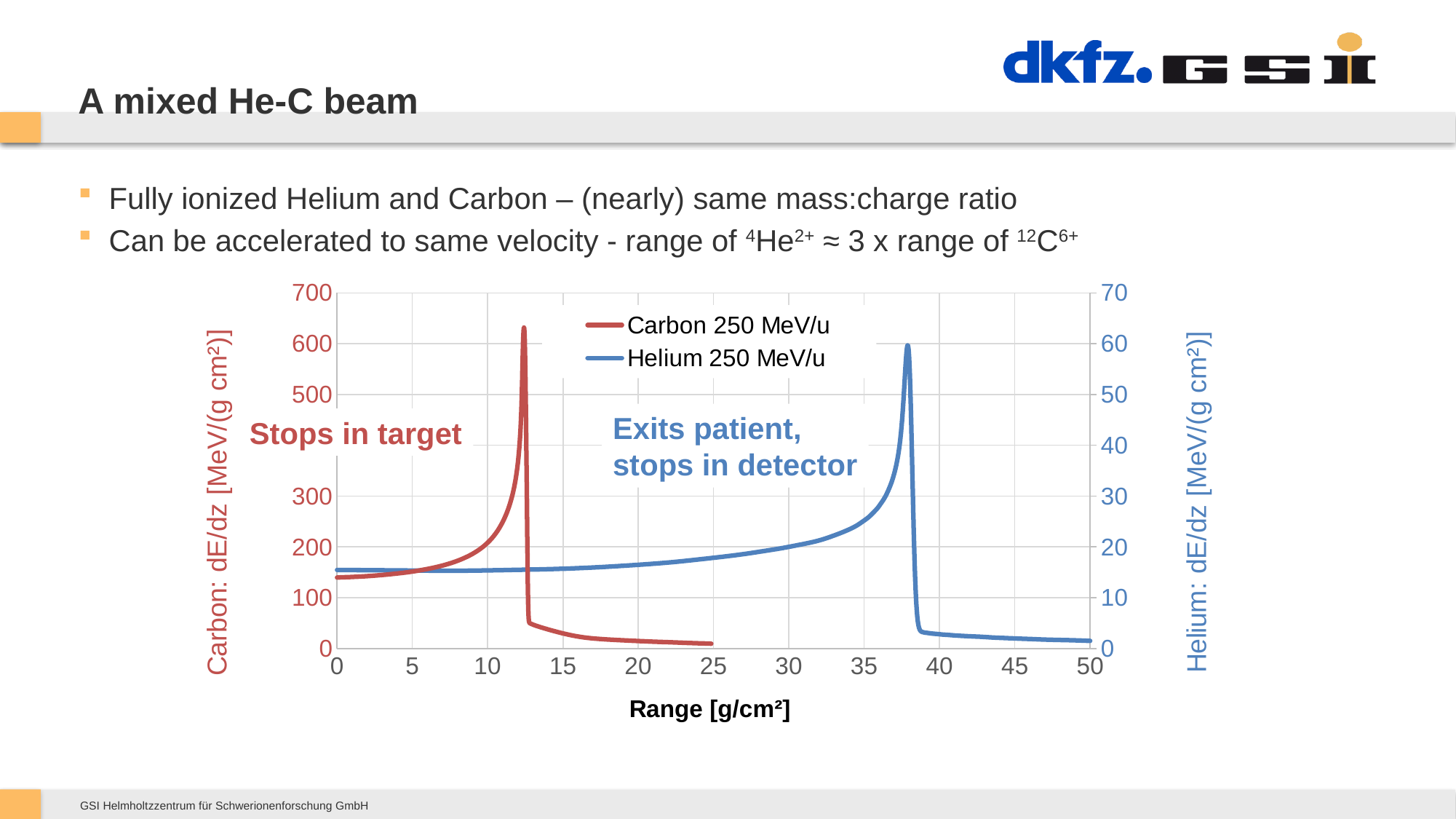
Is the peak value of the Carbon 250 MeV/u curve greater or less than 600 on the left axis? greater How many series does the chart legend list? 2 What kind of chart is shown on the slide? line chart Is the value of the Helium 250 MeV/u curve at a range of 0 greater or less than 10 on the right axis? greater Is the range at which the Carbon 250 MeV/u curve peaks greater or less than 15 g/cm²? less What is the label of the x axis of the chart? Range [g/cm²] What are the two series named in the chart legend? Carbon 250 MeV/u and Helium 250 MeV/u Which series reaches its peak at a larger range, Carbon 250 MeV/u or Helium 250 MeV/u? Helium 250 MeV/u